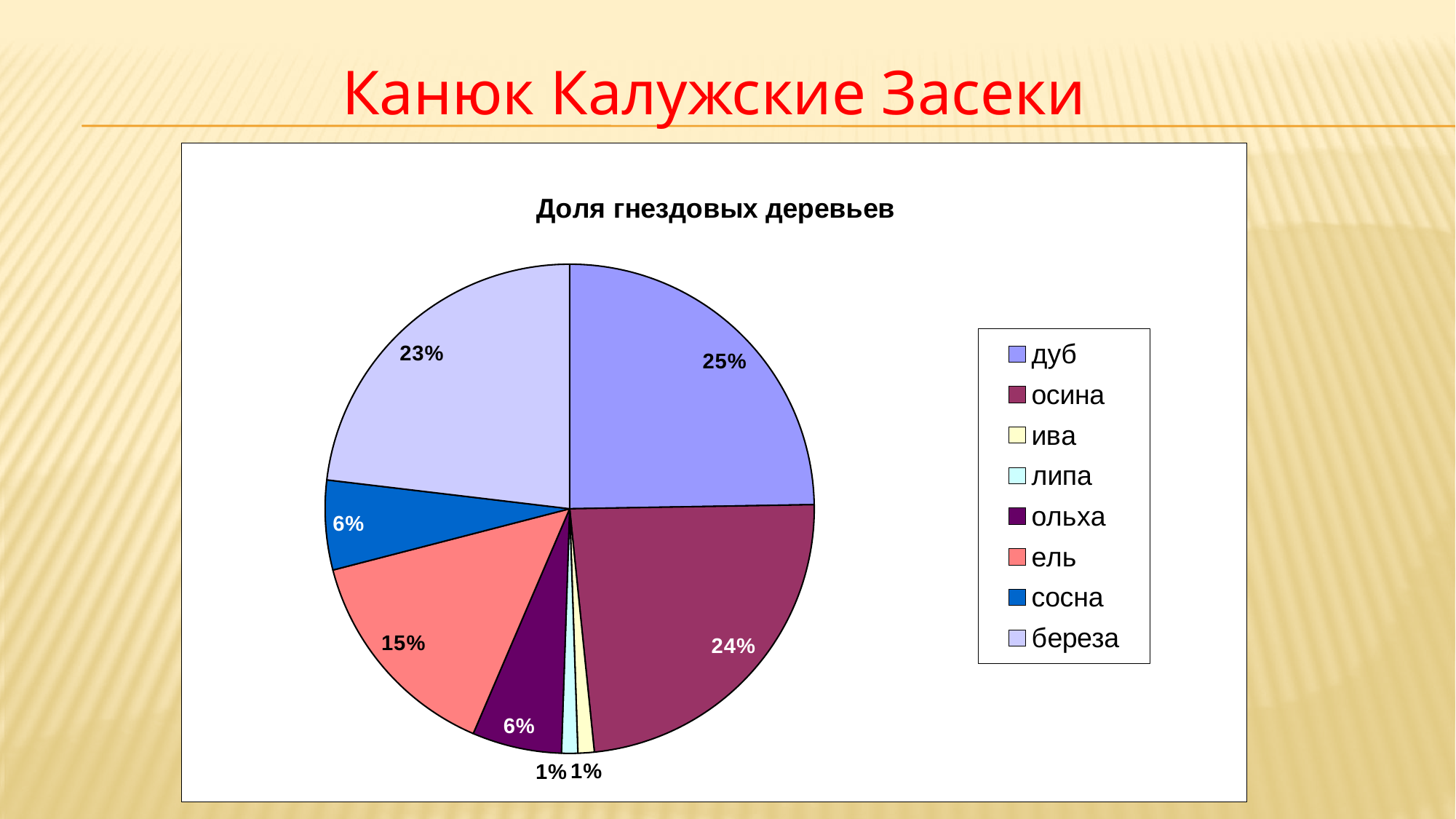
What share of the pie does сосна have? 6% What share of the pie does дуб have? 25% What share of the pie does береза have? 23% How many categories does the legend list? 8 What is the combined share of ель and ольха? 21% Which tree species has the largest share of the pie? дуб What is the title of the chart? Доля гнездовых деревьев Which has a larger share, ель or сосна? ель What is the difference between the shares of дуб and береза? 2% What type of chart is shown on the slide? pie chart